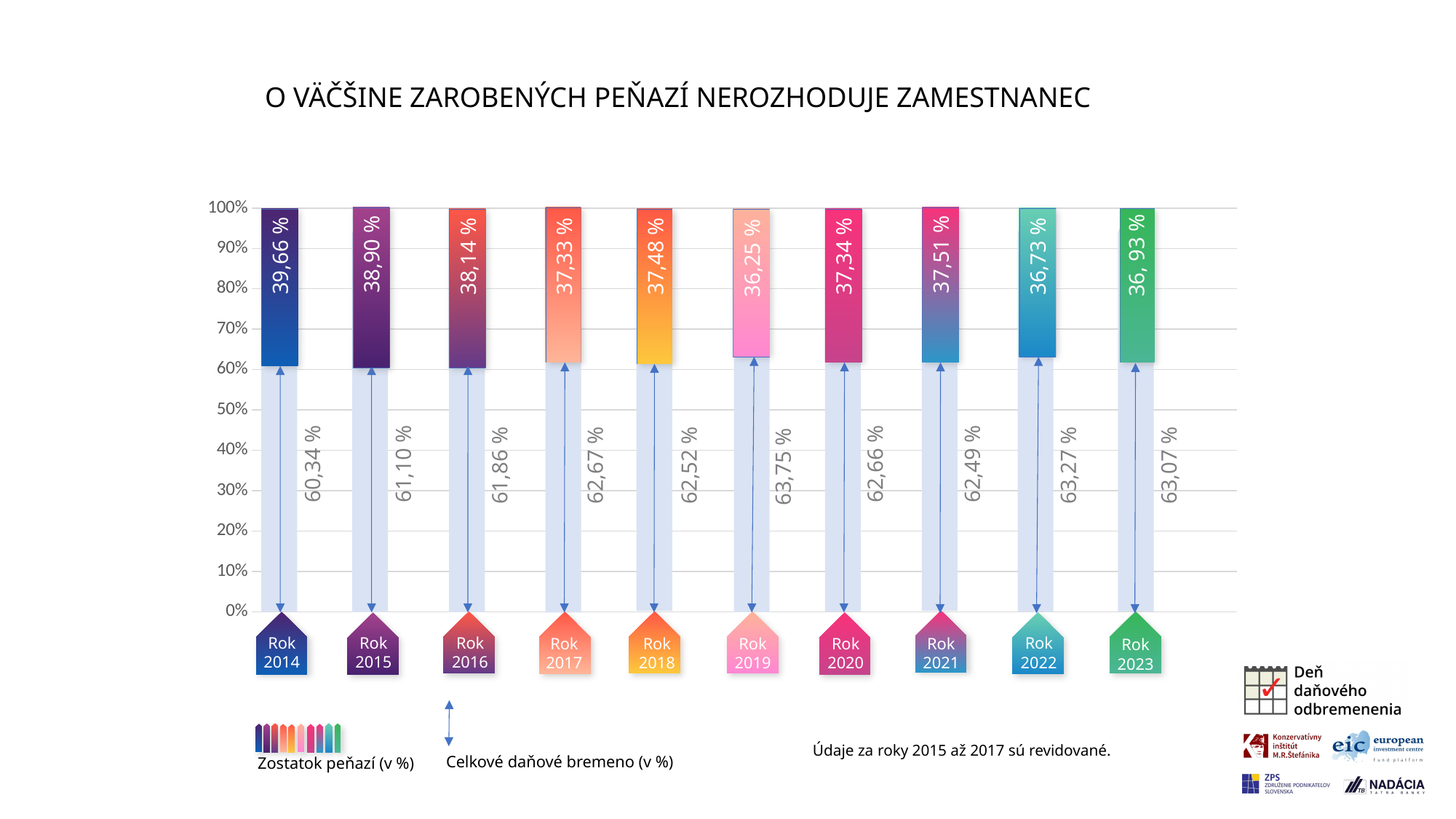
What kind of chart is shown on the slide? Stacked bar chart How many series does the legend list? 2 How many years are shown on the x axis of the chart? 10 What is the difference between Zostatok peňazí (v %) in Rok 2014 and Rok 2023? 2,73 % Which year has the lowest Zostatok peňazí (v %)? Rok 2019 Which year has the larger Zostatok peňazí (v %), Rok 2017 or Rok 2018? Rok 2018 What is the total of the stacked bar for Rok 2014 (Zostatok peňazí plus Celkové daňové bremeno)? 100 % What is the value of Zostatok peňazí (v %) for Rok 2023? 36,93 % What is the value of Zostatok peňazí (v %) for Rok 2014? 39,66 % Which year has the highest Celkové daňové bremeno (v %)? Rok 2019 What is the value of Celkové daňové bremeno (v %) for Rok 2019? 63,75 % Does Celkové daňové bremeno (v %) generally rise or fall from Rok 2014 to Rok 2023? Rise